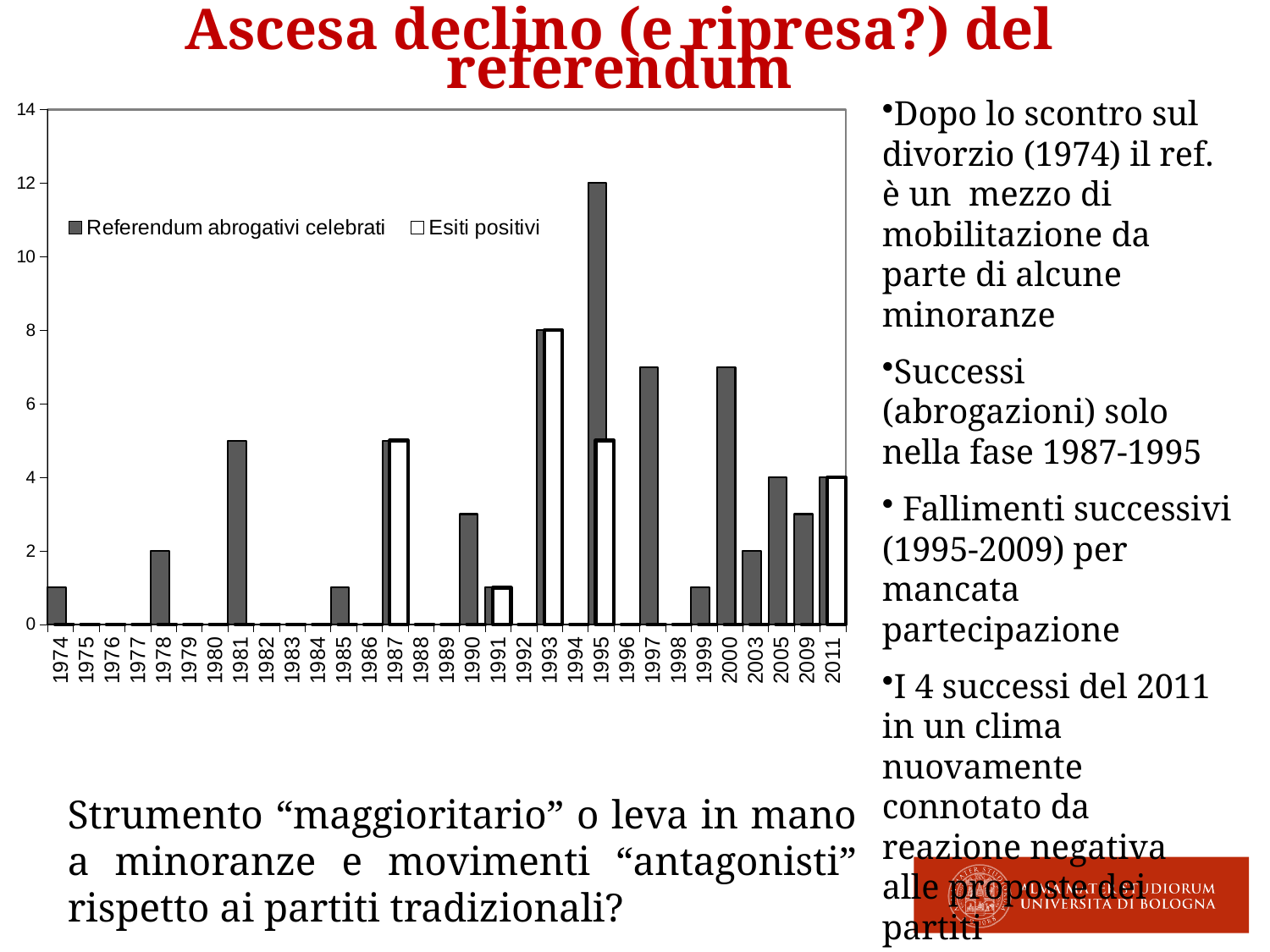
What is the difference between the Referendum abrogativi celebrati values for 1995 and 1993? 4 In which year is the value for Esiti positivi highest? 1993 Is the value for Referendum abrogativi celebrati in 1997 greater or less than 6? greater How many series does the chart legend list? 2 What is the value for Referendum abrogativi celebrati in 2005? 4 What is the value for Referendum abrogativi celebrati in 1995? 12 What kind of chart is shown on the slide? bar chart Is the value for Referendum abrogativi celebrati in 1990 greater or less than 4? less What are the two series named in the chart legend? Referendum abrogativi celebrati and Esiti positivi What is the value for Esiti positivi in 1993? 8 What is the value for Esiti positivi in 2011? 4 In which year is the value for Referendum abrogativi celebrati highest? 1995